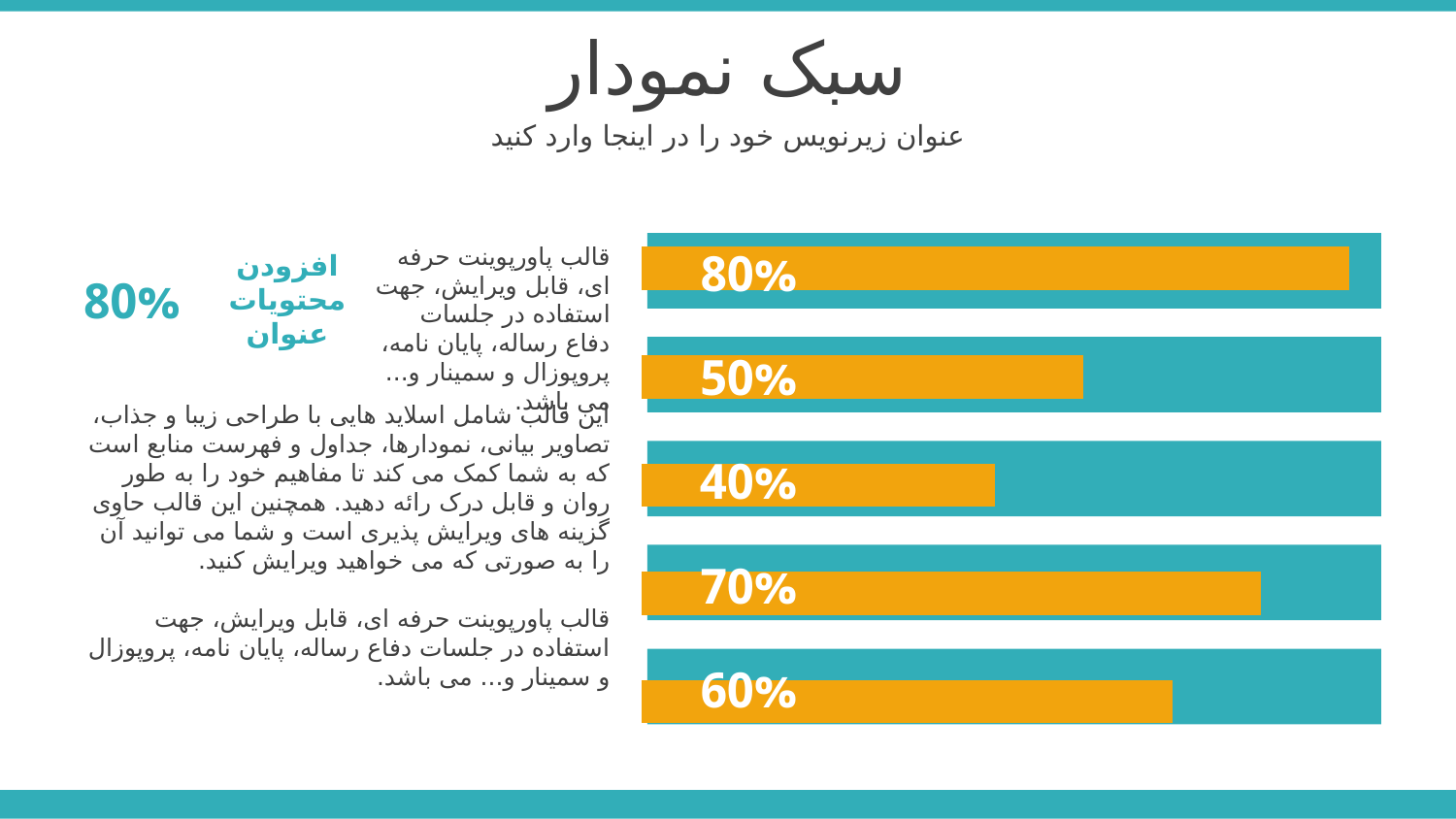
What is the value shown on the bottom bar of the chart? 60% What is the value shown on the middle (third) bar? 40% Which bar has the highest value? the top bar (80%) What is the value shown on the top bar of the chart? 80% How many bars does the chart contain? 5 What is the difference between the top bar's value and the bottom bar's value? 20% What kind of chart is shown on the slide? bar chart Which is larger, the value of the second bar from the top or the value of the fourth bar from the top? the fourth bar (70%) What is the value shown on the fourth bar from the top? 70% What colour are the bars in the chart? orange Which bar has the lowest value? the middle (third) bar (40%) What is the value shown on the second bar from the top? 50%